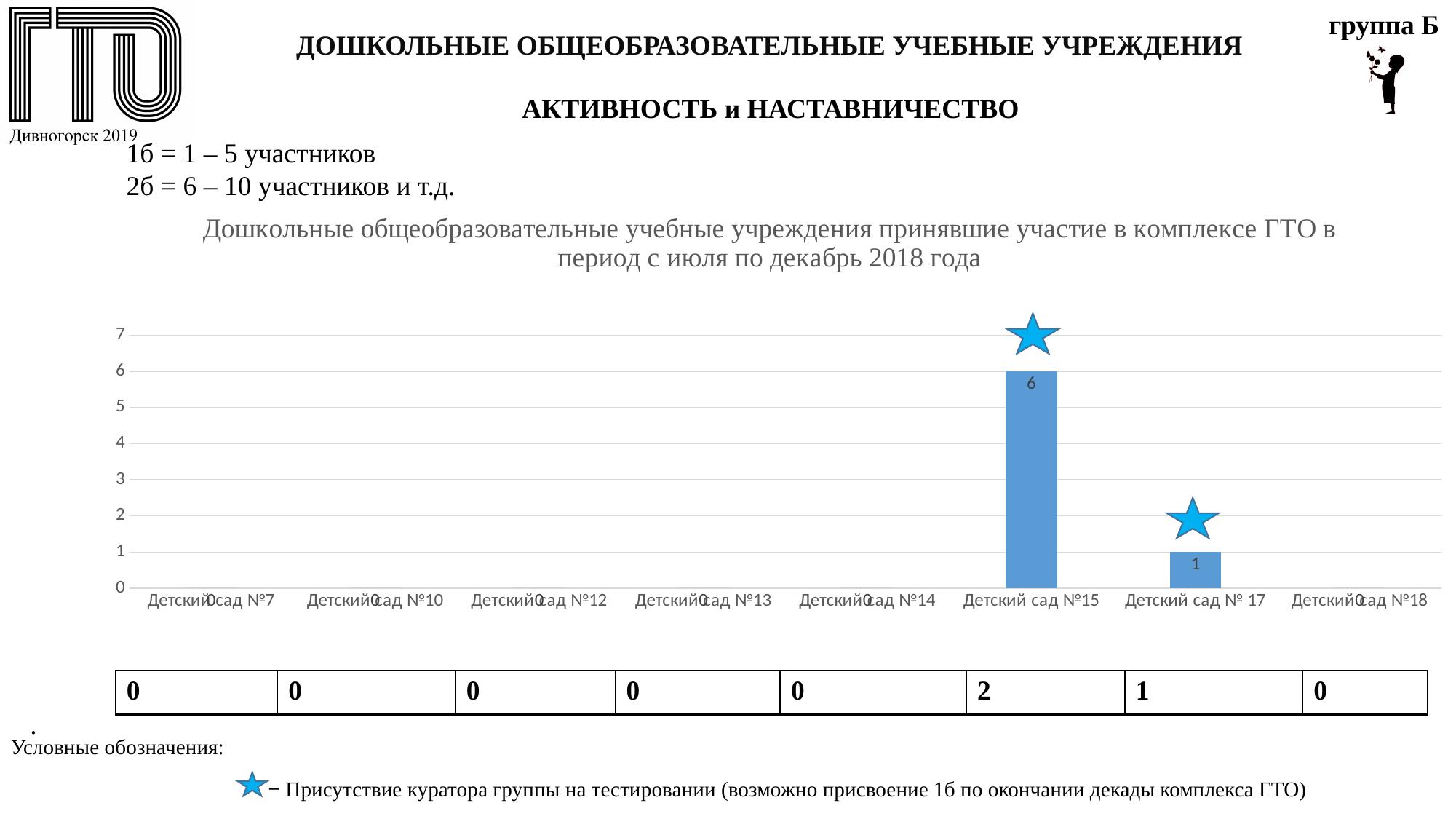
How many categories are shown on the x axis? 8 What is the value for Детский сад № 17? 1 Which is larger, the value for Детский сад №15 or the value for Детский сад № 17? Детский сад №15 What is the value for Детский сад №10? 0 What type of chart is shown on the slide? bar chart What is the title of the chart? Дошкольные общеобразовательные учебные учреждения принявшие участие в комплексе ГТО в период с июля по декабрь 2018 года What is the difference between the values for Детский сад №15 and Детский сад № 17? 5 What is the highest tick value shown on the y axis? 7 Is the value for Детский сад №15 greater or less than 5? greater Which category has the highest value? Детский сад №15 How many categories have a value of 0? 6 What is the value for Детский сад №15? 6